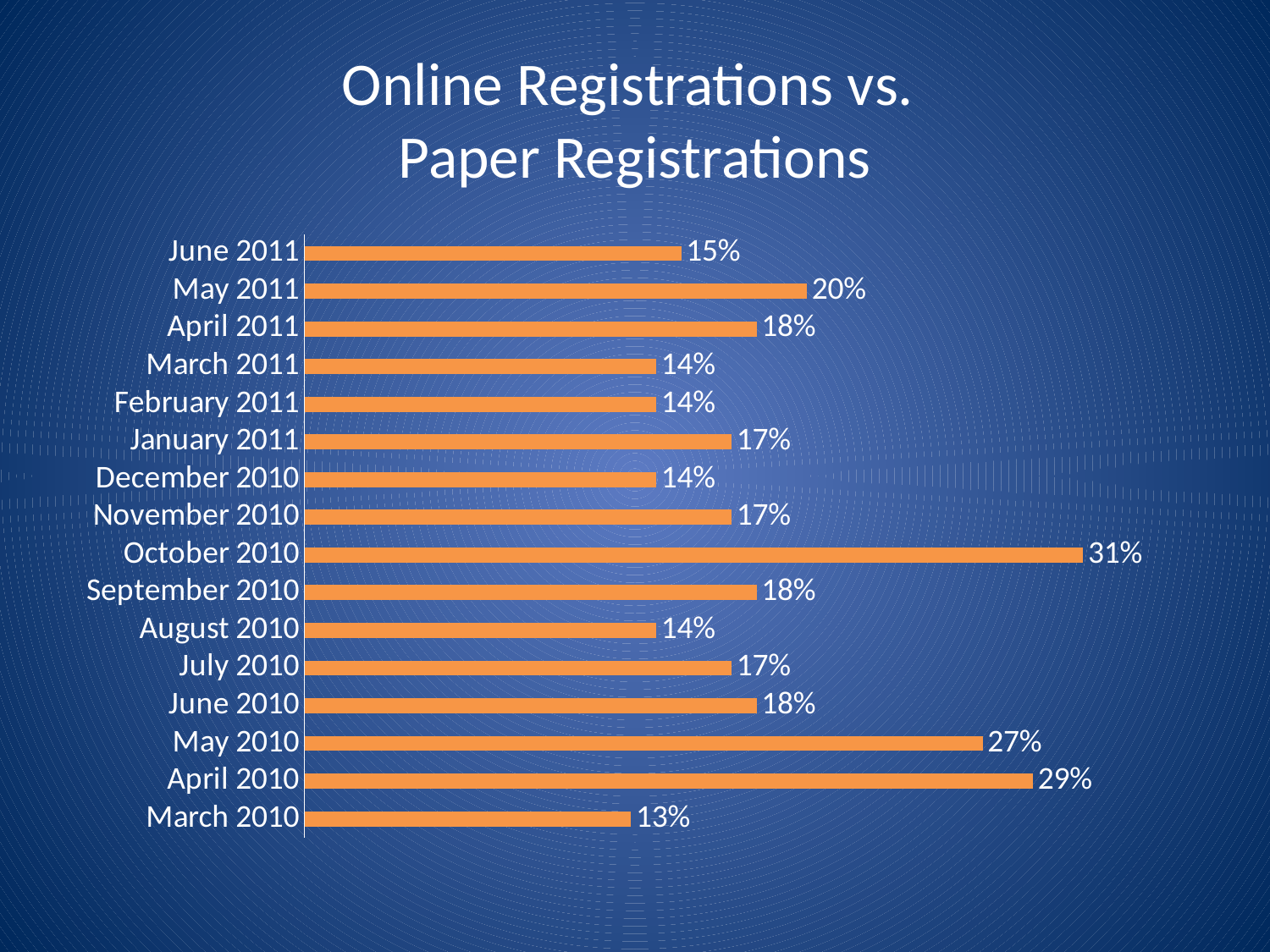
What is the title of the chart? Online Registrations vs. Paper Registrations Which is larger, the value for May 2011 or the value for June 2011? May 2011 What is the difference between the values for October 2010 and March 2010? 18% What is the value for May 2011? 20% What is the value for October 2010? 31% What is the value for April 2010? 29% What is the difference between the values for April 2010 and May 2010? 2% What is the value for March 2010? 13% How many months are shown in the chart? 16 Which month has the lowest value? March 2010 Which month has the highest value? October 2010 What kind of chart is shown on the slide? Bar chart